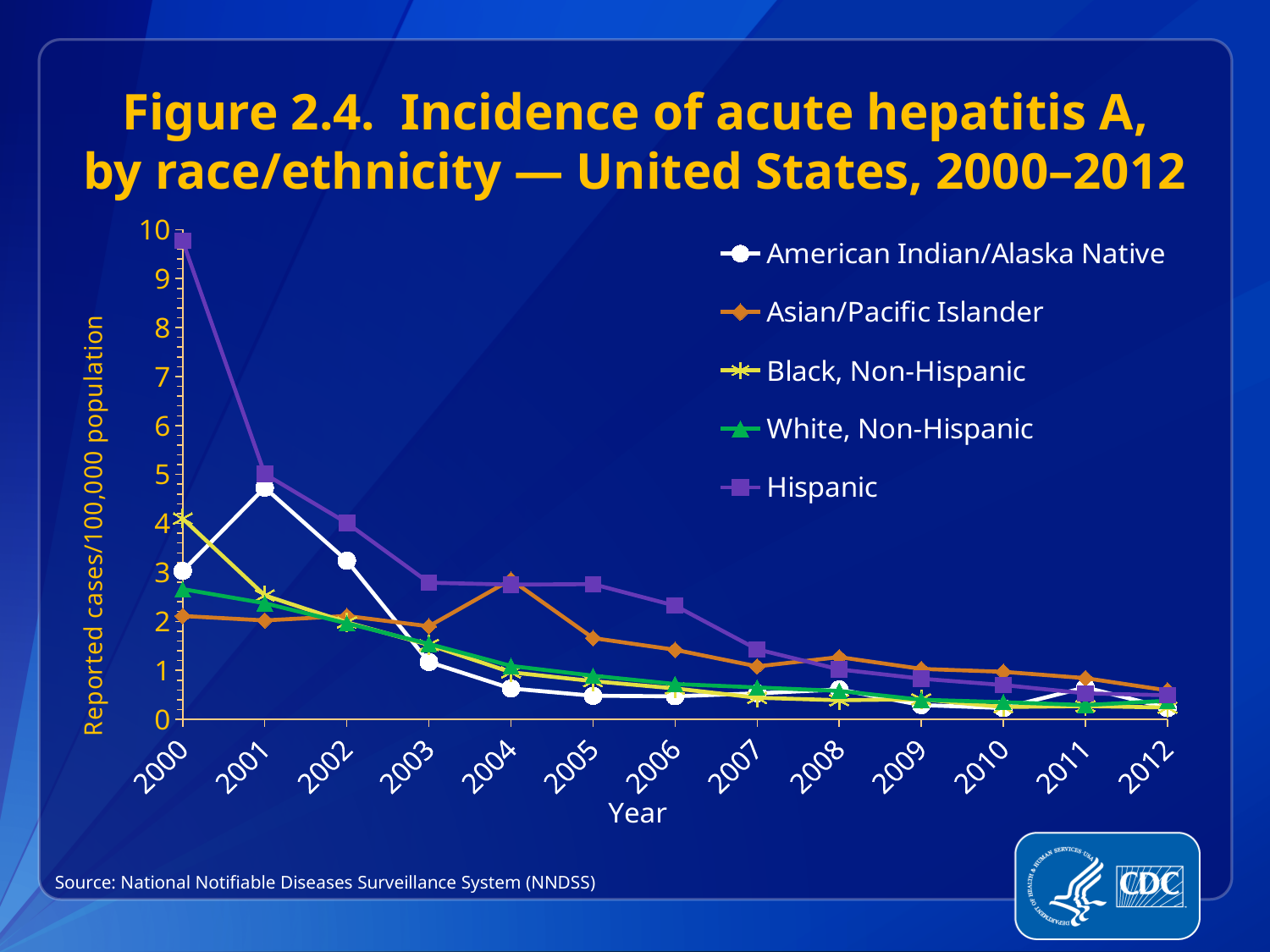
What is the label on the y axis? Reported cases/100,000 population In 2002, which is larger: the value for American Indian/Alaska Native or the value for Asian/Pacific Islander? American Indian/Alaska Native How many series does the legend list? 5 How many years are plotted along the x axis? 13 Is the value for Hispanic in 2000 greater or less than 9? greater Which group had the highest incidence in 2005? Hispanic Is the value for American Indian/Alaska Native in 2001 greater or less than 4? greater Does the Hispanic series generally rise or fall from 2000 to 2012? Fall What kind of chart is shown on the slide? Line chart Which group had the lowest incidence in 2004? American Indian/Alaska Native Is the value for Hispanic in 2003 greater or less than 3? less Which race/ethnicity group had the highest incidence in 2000? Hispanic